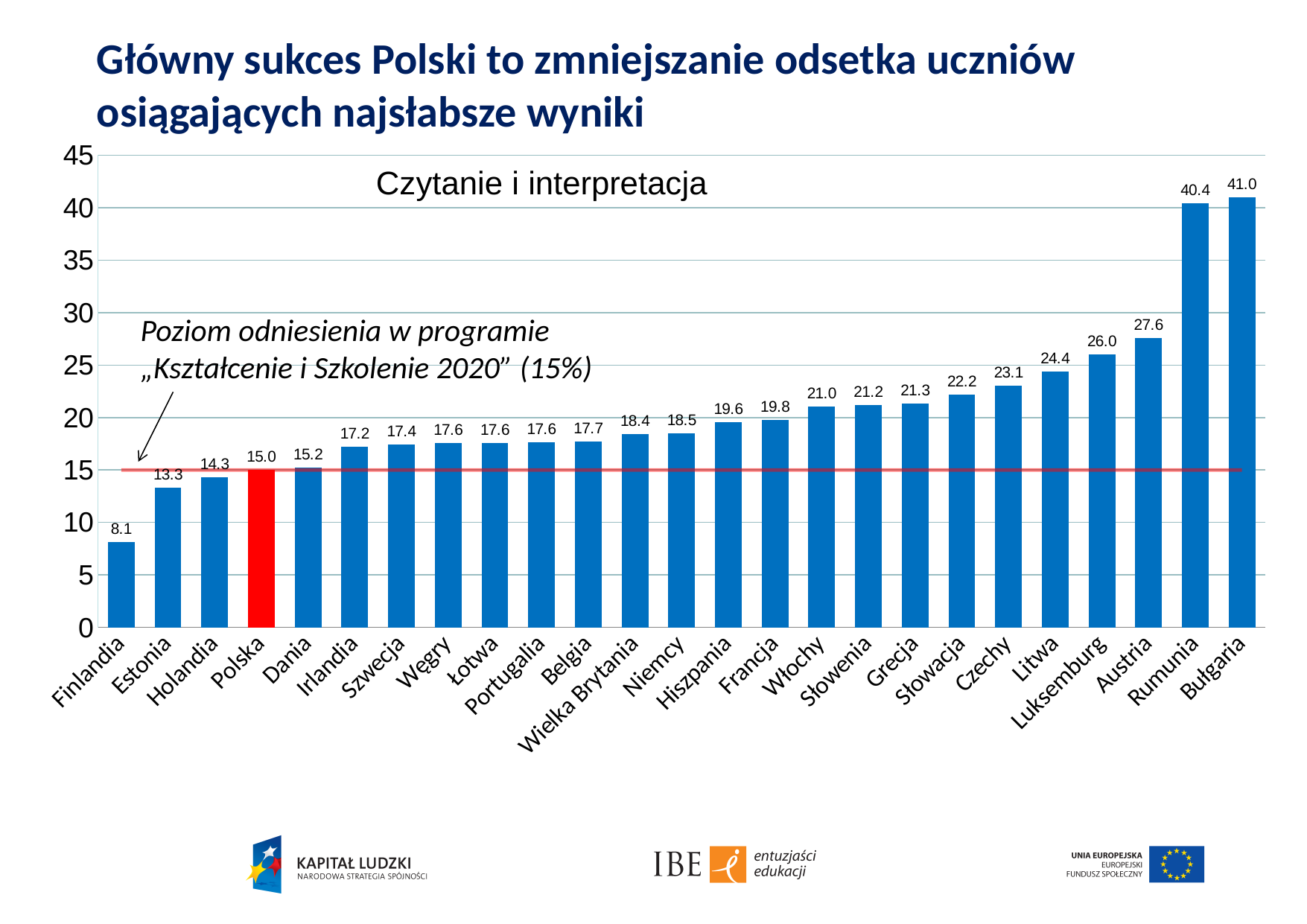
Do the values rise or fall from left to right along the x axis? rise What is the value for Austria? 27.6 Which has a larger value, Francja or Hiszpania? Francja What is the difference between the values for Rumunia and Polska? 25.4 How many countries are shown on the chart? 25 Is the value for Luksemburg greater or less than 25? greater Which country's bar is coloured red? Polska What kind of chart is shown on the slide? bar chart Which country has the lowest value? Finlandia Which country has the highest value? Bułgaria What is the value for Niemcy? 18.5 What is the value for Polska? 15.0